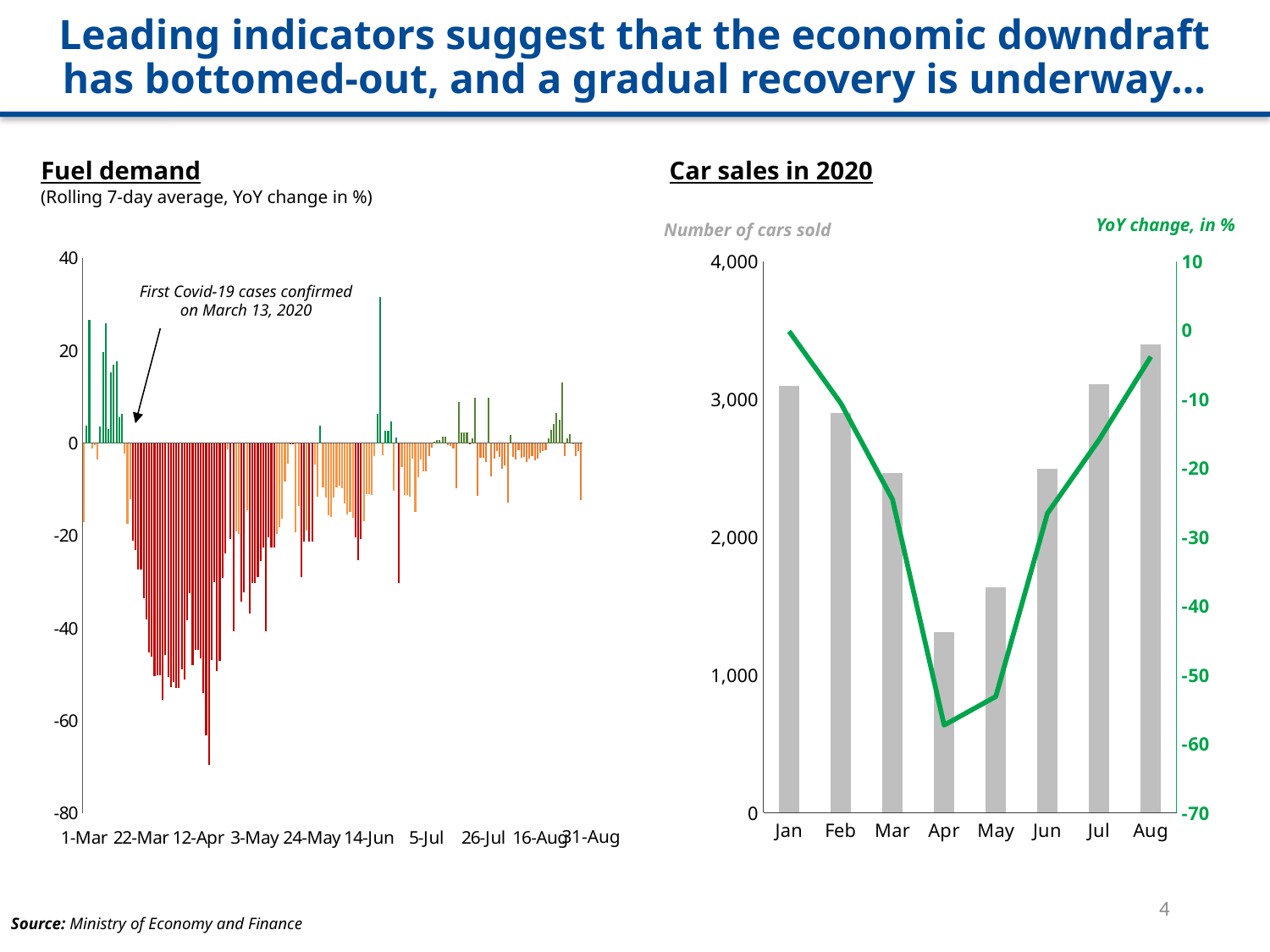
In the 'Car sales in 2020' chart, is the number of cars sold in Aug greater or less than 3,000? greater In the 'Car sales in 2020' chart, which month has the highest number of cars sold? Aug What kind of chart is the 'Fuel demand' chart? Bar chart In the 'Car sales in 2020' chart, which month has more cars sold, Jan or Feb? Jan In the 'Car sales in 2020' chart, is the YoY change for Apr greater or less than -50? less In the 'Car sales in 2020' chart, how many months are shown on the x axis? 8 In the 'Car sales in 2020' chart, is the number of cars sold in Apr greater or less than 2,000? less According to the annotation on the 'Fuel demand' chart, on what date were the first Covid-19 cases confirmed? March 13, 2020 In the 'Car sales in 2020' chart, which month has the lowest number of cars sold? Apr In the 'Car sales in 2020' chart, do the number of cars sold rise or fall from Apr to Aug? Rise What kind of chart is the 'Car sales in 2020' chart? Combined bar and line chart In the 'Car sales in 2020' chart, in which month is the YoY change line at its lowest? Apr